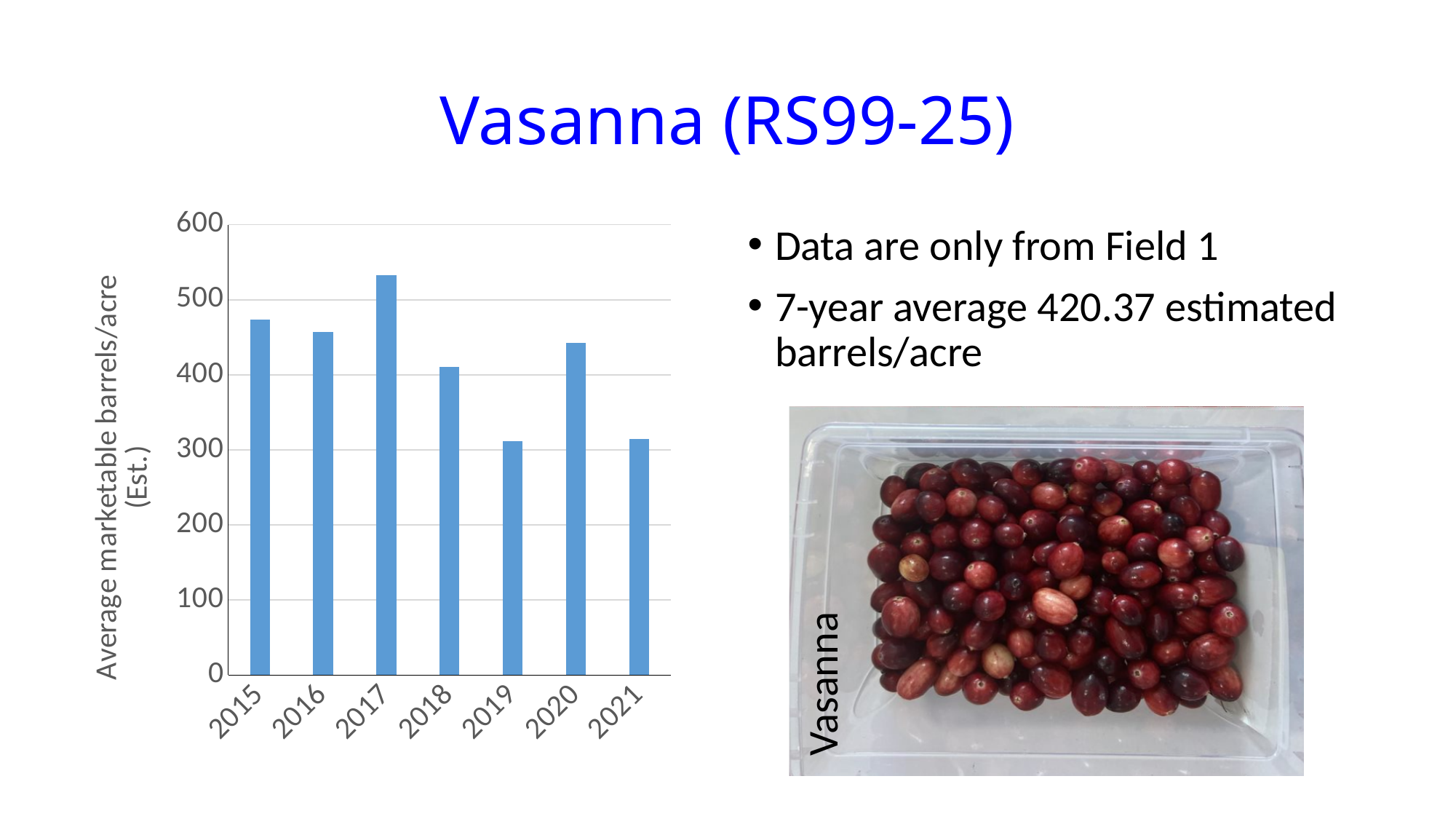
Which year has the larger value, 2020 or 2019? 2020 Is the value for 2019 greater or less than 400? less Is the value for 2018 greater or less than 500? less Which year has the highest average marketable barrels/acre? 2017 Do the values rise or fall from 2017 to 2019? fall Which year has the larger value, 2017 or 2018? 2017 Is the value for 2017 greater or less than 500? greater How many years are plotted on the chart? 7 What kind of chart is shown on the slide? bar chart What is the label on the vertical axis of the chart? Average marketable barrels/acre (Est.)